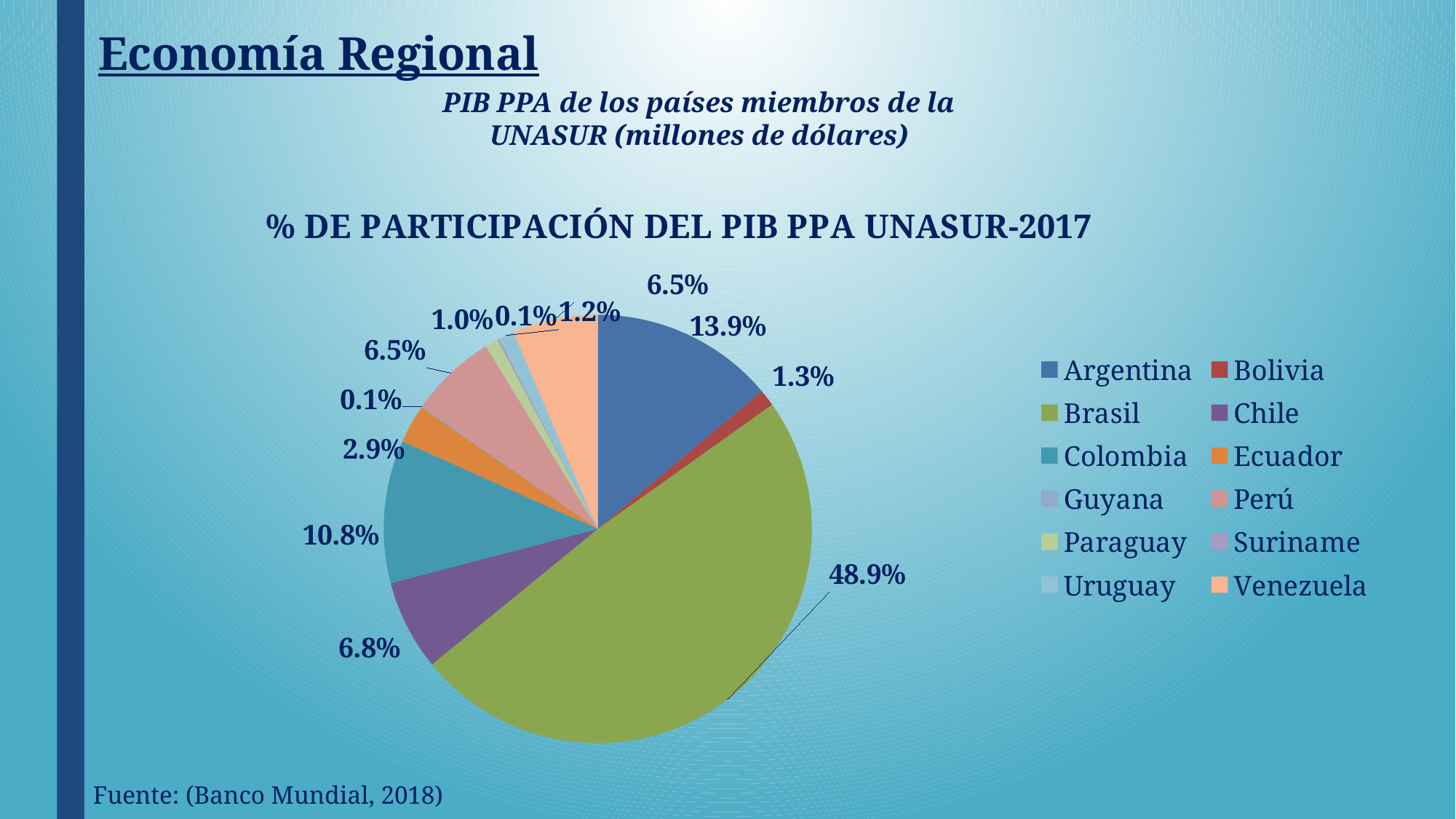
What is the value labelled for Chile in the pie chart? 6.8% What share of the pie does Brasil hold in the chart '% DE PARTICIPACIÓN DEL PIB PPA UNASUR-2017'? 48.9% How many countries are listed in the legend of the pie chart? 12 What percentage is shown for Colombia in the pie chart? 10.8% What is the title of the chart on the slide? % DE PARTICIPACIÓN DEL PIB PPA UNASUR-2017 What percentage does Ecuador account for in the pie chart? 2.9% Which has a larger share in the pie chart, Argentina or Colombia? Argentina Which has a larger share in the pie chart, Chile or Ecuador? Chile What is the difference between Brasil's share and Argentina's share in the pie chart? 35.0% What is the value shown for Argentina in the pie chart? 13.9% Which country has the largest slice in the pie chart? Brasil What type of chart is shown on the slide? Pie chart